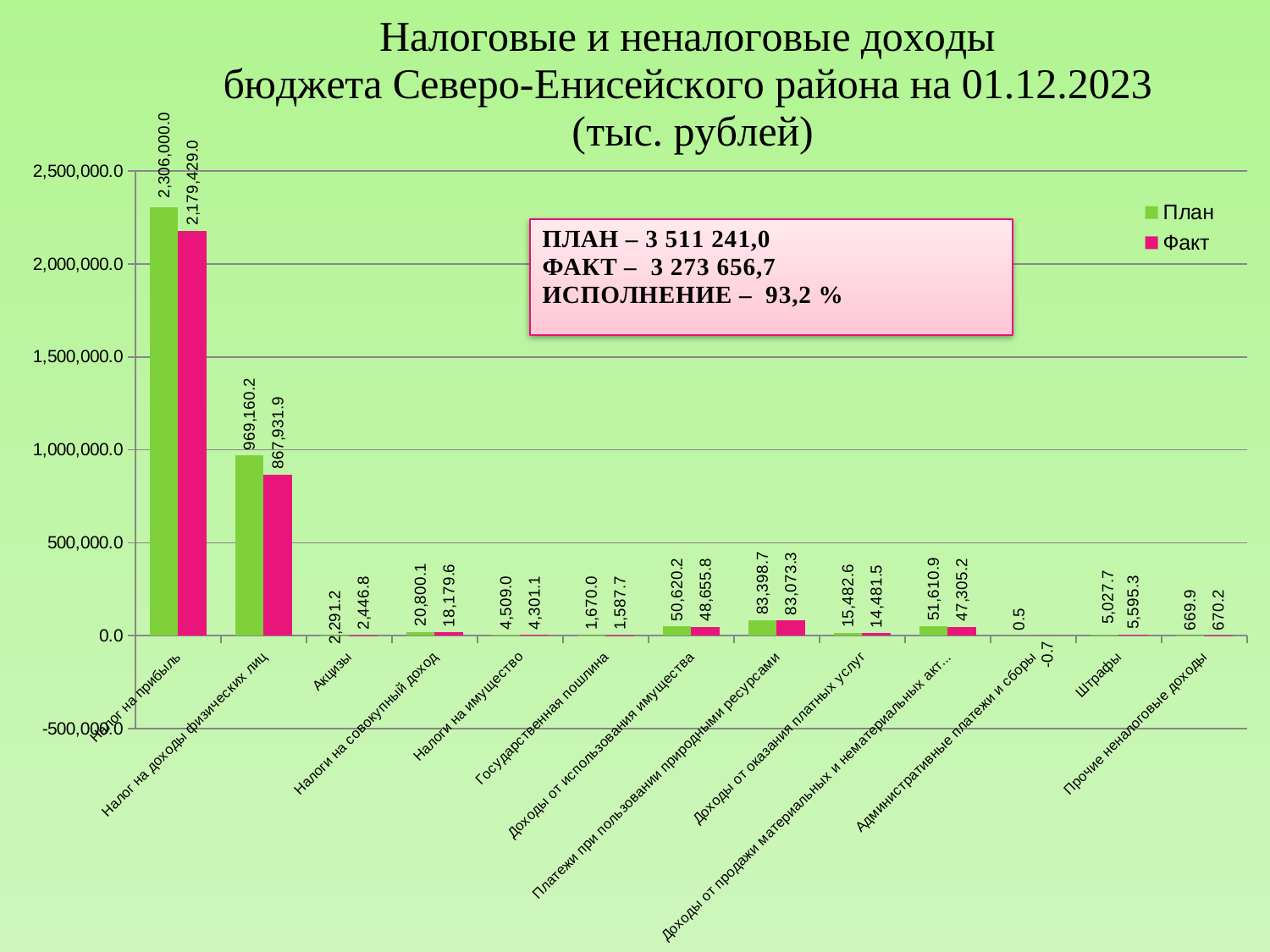
What is the Факт value for Платежи при пользовании природными ресурсами? 83,073.3 Which category has the highest План value? Налог на прибыль What is the Факт value for Налог на доходы физических лиц? 867,931.9 What is the difference between the План and Факт values for Налоги на совокупный доход? 2,620.5 What kind of chart is shown on the slide? Bar chart What is the План value for Штрафы? 5,027.7 What is the План value for Налог на прибыль? 2,306,000.0 How many series does the legend list? 2 Which category has the lowest Факт value? Административные платежи и сборы For Акцизы, which is larger: the План value or the Факт value? Факт What is the difference between the План and Факт values for Налог на прибыль? 126,571.0 How many categories are shown on the x axis? 13